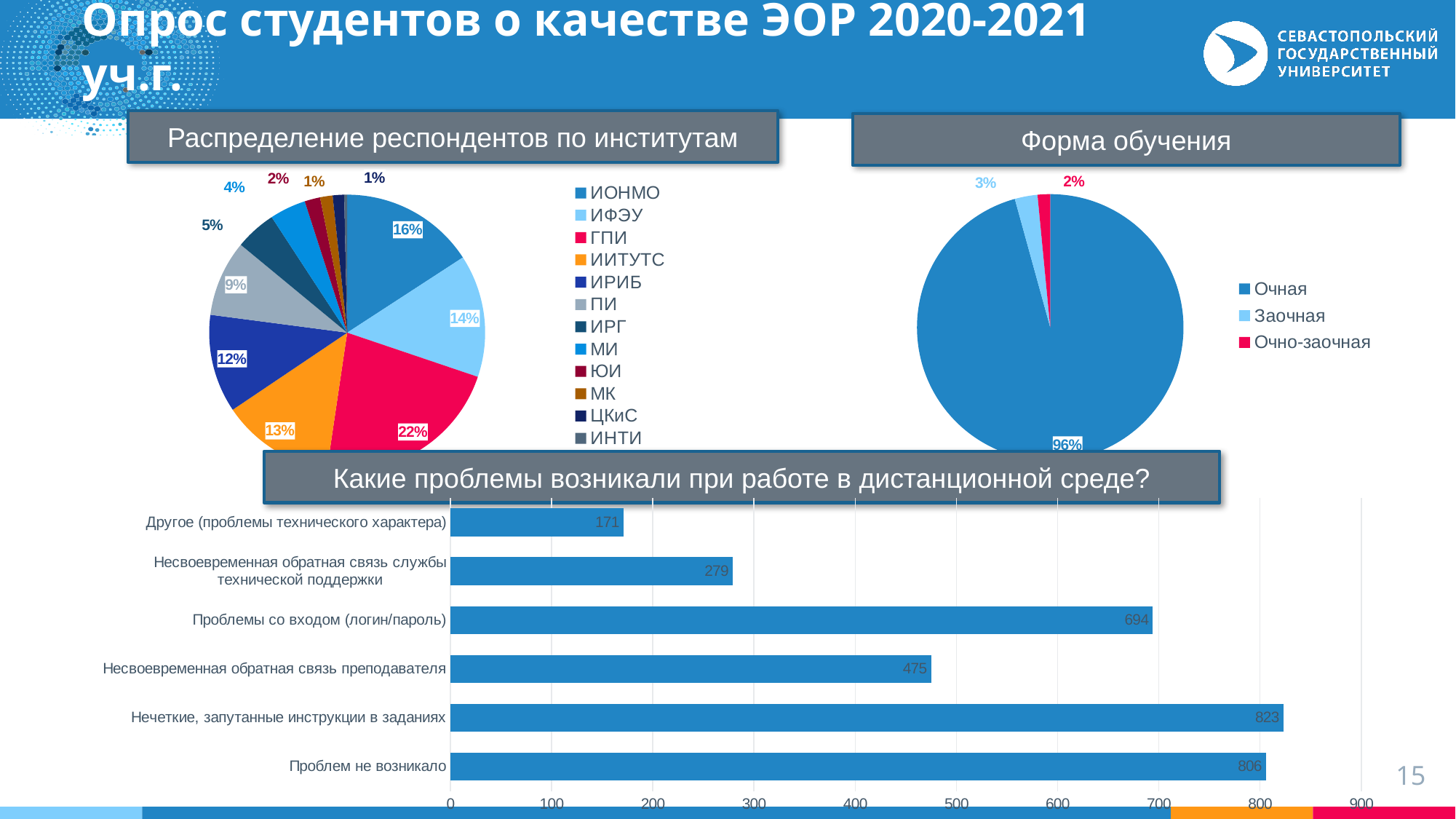
In the 'Какие проблемы возникали при работе в дистанционной среде?' chart, what is the value for 'Проблемы со входом (логин/пароль)'? 694 How many entries does the legend of the 'Распределение респондентов по институтам' pie chart list? 12 How many categories are shown in the 'Какие проблемы возникали при работе в дистанционной среде?' chart? 6 In the 'Какие проблемы возникали при работе в дистанционной среде?' chart, which category has the lowest value? Другое (проблемы технического характера) In the 'Форма обучения' pie chart, which is larger: 'Заочная' or 'Очно-заочная'? Заочная In the 'Форма обучения' pie chart, what share does 'Очная' have? 96% In the 'Распределение респондентов по институтам' pie chart, what share does ГПИ have? 22% In the 'Какие проблемы возникали при работе в дистанционной среде?' chart, what is the difference between 'Нечеткие, запутанные инструкции в заданиях' and 'Проблем не возникало'? 17 In the 'Какие проблемы возникали при работе в дистанционной среде?' chart, which category has the highest value? Нечеткие, запутанные инструкции в заданиях In the 'Распределение респондентов по институтам' pie chart, what share does ИРИБ have? 12% In the 'Какие проблемы возникали при работе в дистанционной среде?' chart, which is larger: 'Несвоевременная обратная связь преподавателя' or 'Несвоевременная обратная связь службы технической поддержки'? Несвоевременная обратная связь преподавателя What type of chart is 'Какие проблемы возникали при работе в дистанционной среде?'? bar chart